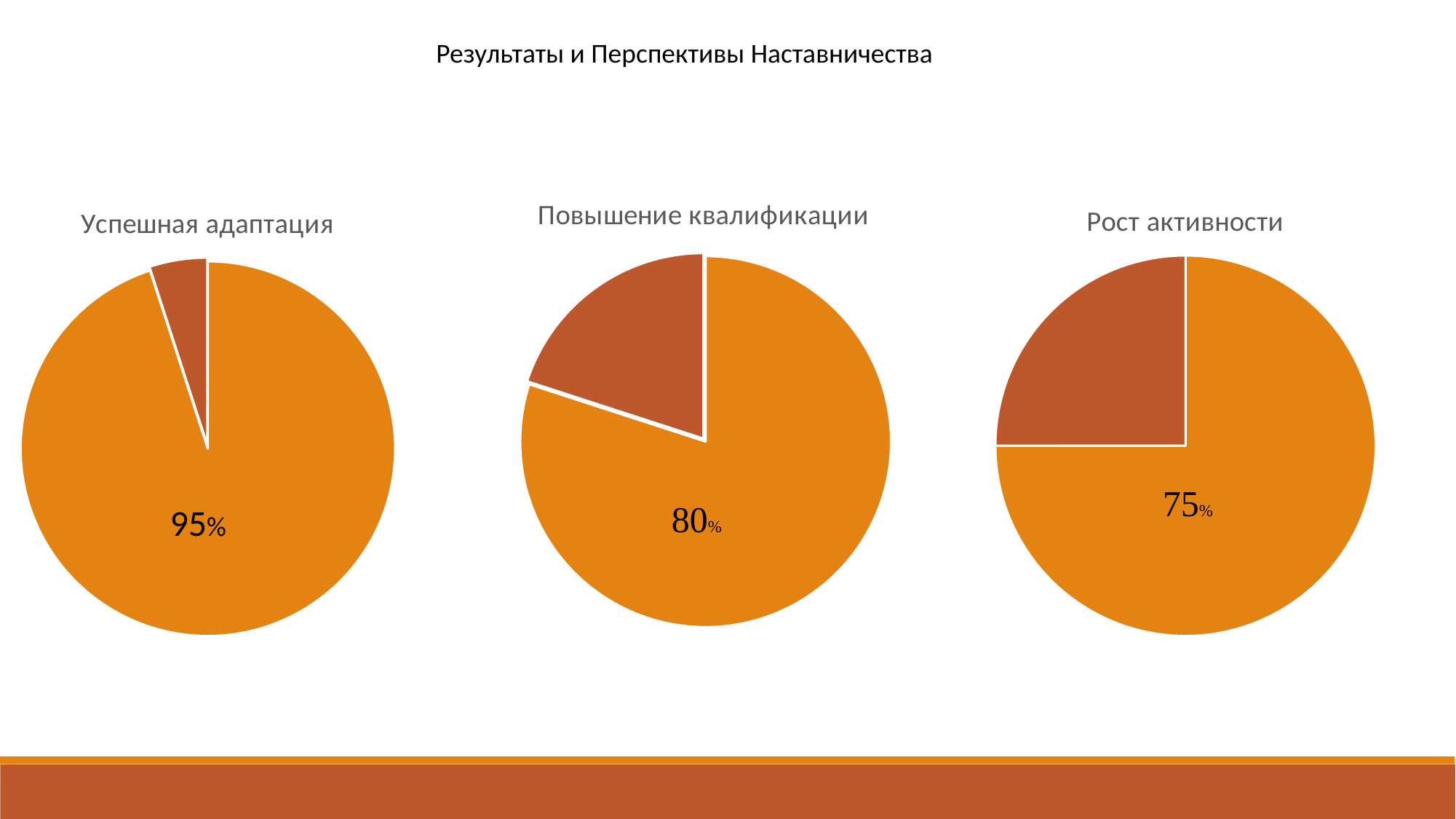
In the "Успешная адаптация" chart, what value is printed on the large slice? 95% What kind of chart is the "Успешная адаптация" chart? pie chart In the "Повышение квалификации" chart, what value is printed on the large slice? 80% What is the difference between the labelled value in the "Успешная адаптация" chart and the labelled value in the "Рост активности" chart? 20% Which is larger: the labelled value in the "Повышение квалификации" chart or in the "Рост активности" chart? Повышение квалификации Which of the three pie charts shows the lowest labelled percentage? Рост активности What is the difference between the labelled value in the "Успешная адаптация" chart and the labelled value in the "Повышение квалификации" chart? 15% How many slices does the "Рост активности" pie chart have? 2 In the "Рост активности" chart, what value is printed on the large slice? 75% What is the title of the slide above the three pie charts? Результаты и Перспективы Наставничества Which of the three pie charts shows the highest labelled percentage? Успешная адаптация How many pie charts are shown on the slide? 3